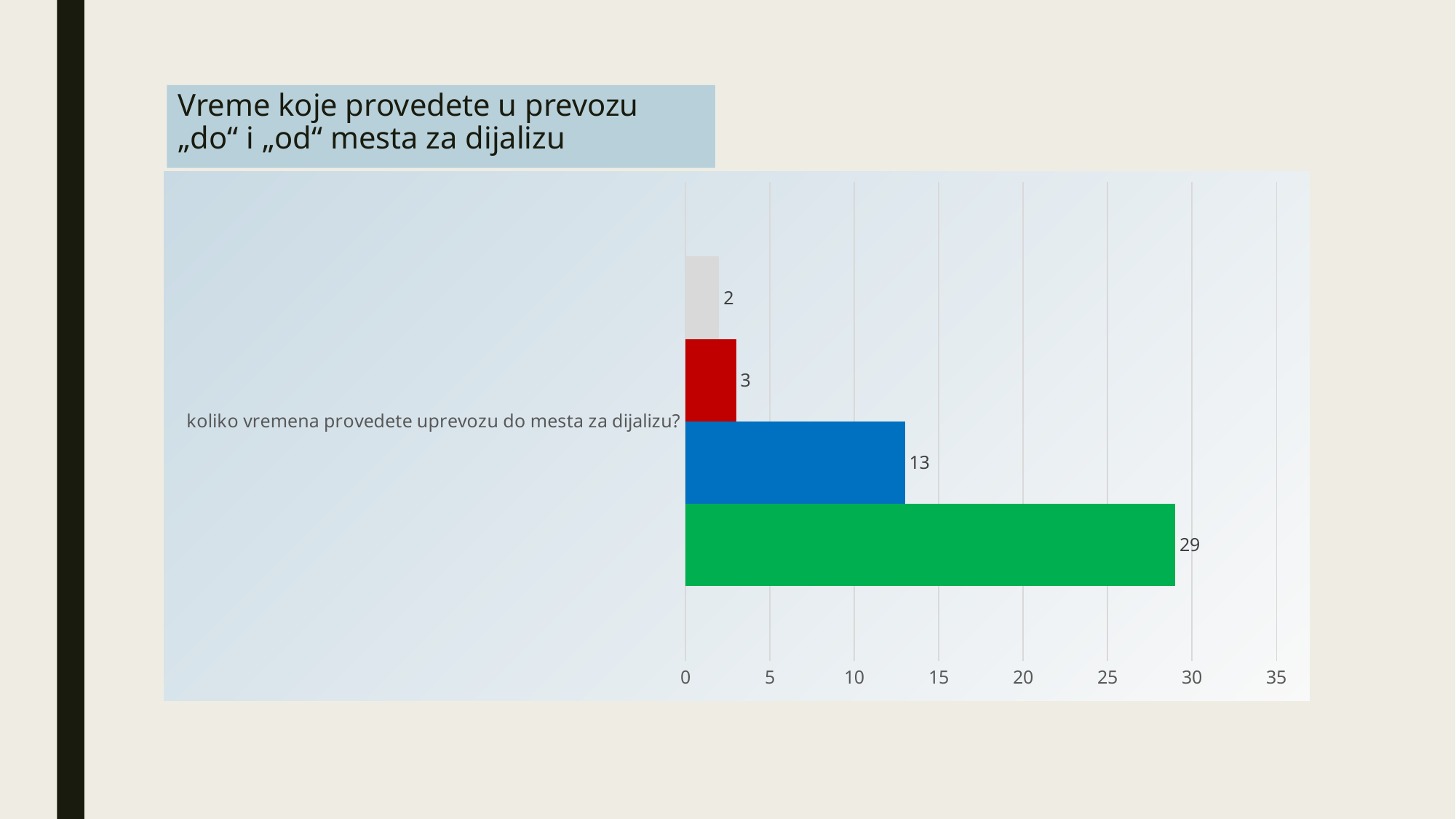
What is the value of the green bar? 29 What is the value of the grey bar? 2 Which bar has the highest value? the green bar (29) What is the value of the blue bar? 13 Which bar has the lowest value? the grey bar (2) What is the highest value shown on the horizontal axis? 35 What is the title of the chart? Vreme koje provedete u prevozu „do“ i „od“ mesta za dijalizu What is the value of the red bar? 3 Which is larger, the red bar or the blue bar? the blue bar What is the difference between the green bar and the blue bar? 16 What kind of chart is shown on the slide? bar chart How many bars are plotted in the chart? 4